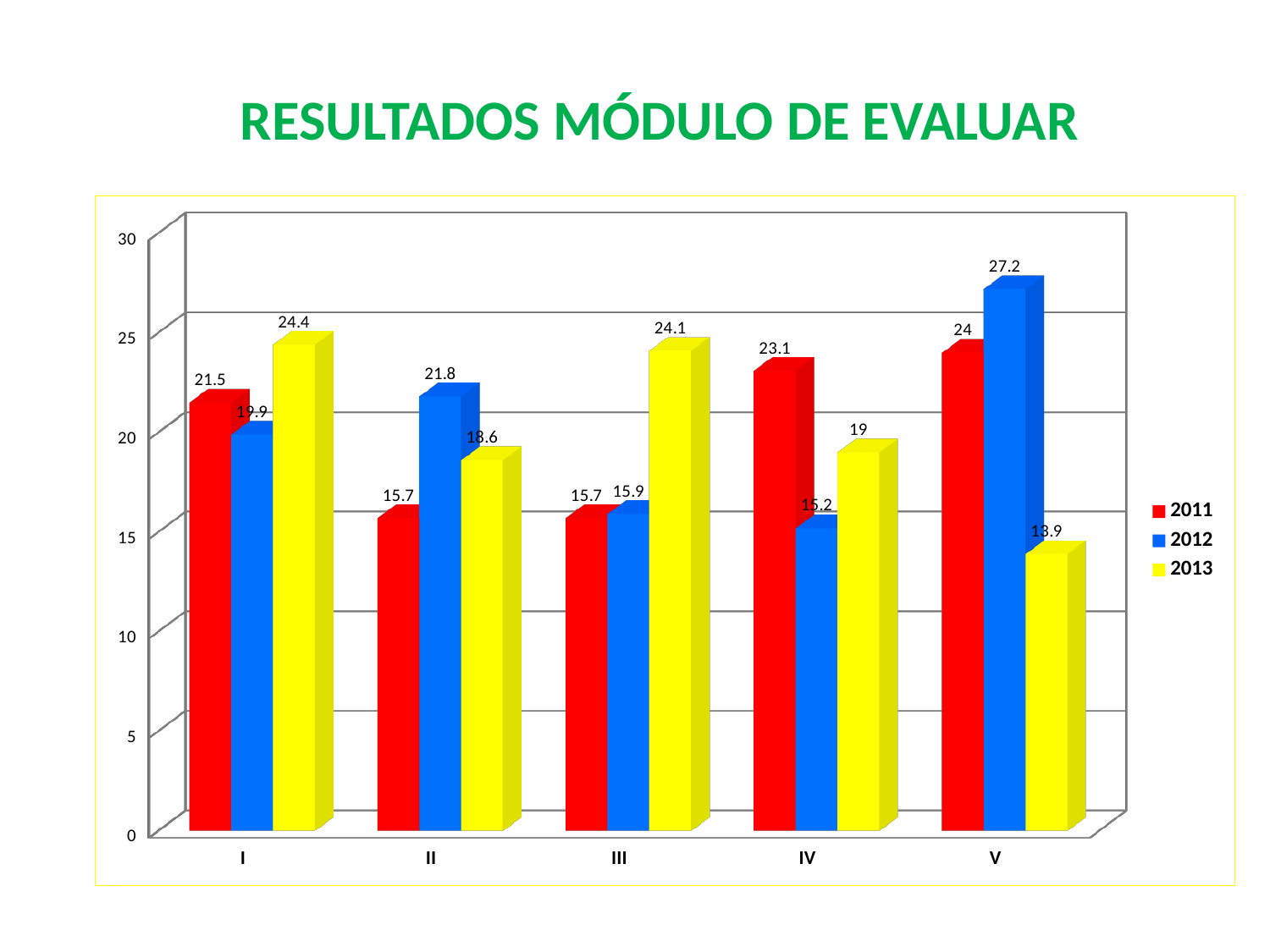
How many categories are shown on the x axis? 5 Is the value for 2013 in category III greater or less than 20? greater Which is larger in category II: the 2011 value or the 2012 value? 2012 What is the title of the chart? RESULTADOS MÓDULO DE EVALUAR Which category has the lowest value for the 2013 series? V What kind of chart is shown on the slide? bar chart What is the value for 2011 in category IV? 23.1 How many series does the legend list? 3 Which category has the highest value for the 2012 series? V What is the value for 2012 in category V? 27.2 What is the difference between the 2012 and 2013 values in category V? 13.3 What is the value for 2013 in category I? 24.4